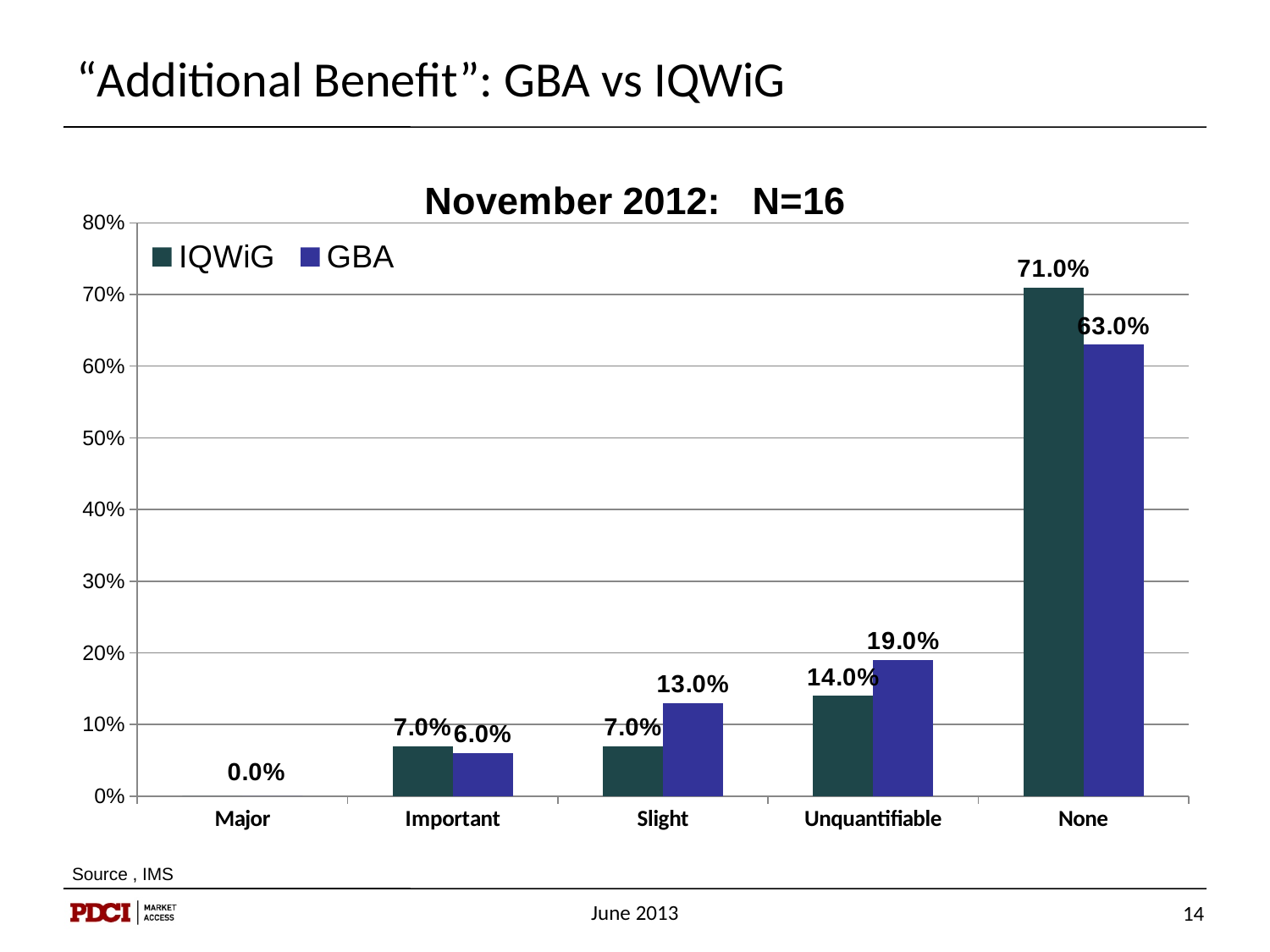
What is the GBA value for Unquantifiable? 19.0% What is the GBA value for Slight? 13.0% What is the difference between the GBA and IQWiG values for Slight? 6.0% How many categories are shown on the x axis? 5 Which is larger for Unquantifiable, the IQWiG value or the GBA value? GBA Is the GBA value for None greater or less than 60%? greater How many series does the legend list? 2 What is the difference between the IQWiG and GBA values for None? 8.0% Which category has the highest GBA value? None What is the IQWiG value for Important? 7.0% What kind of chart is shown on the slide? Bar chart What is the IQWiG value for None? 71.0%